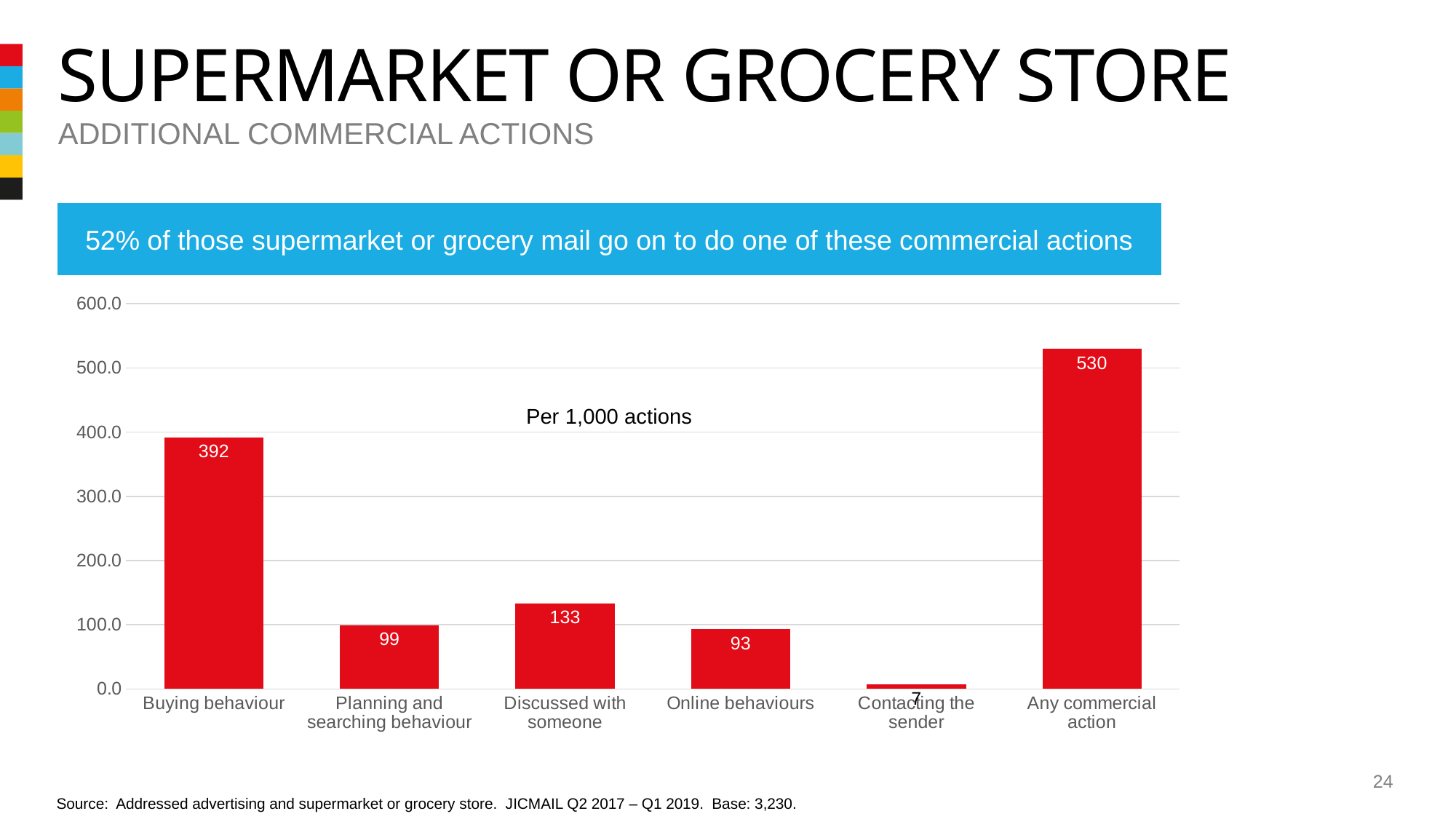
What is the value for Discussed with someone? 133 What is the value for Contacting the sender? 7 How many categories are shown on the x axis? 6 Is the value for Online behaviours greater or less than 100.0? less What unit label is printed inside the chart area? Per 1,000 actions Which is larger, the value for Discussed with someone or the value for Online behaviours? Discussed with someone What is the value for Buying behaviour? 392 What kind of chart is shown on the slide? bar chart Which category has the lowest value? Contacting the sender What is the difference between the values for Any commercial action and Buying behaviour? 138 Which category has the highest value? Any commercial action What is the value for Planning and searching behaviour? 99